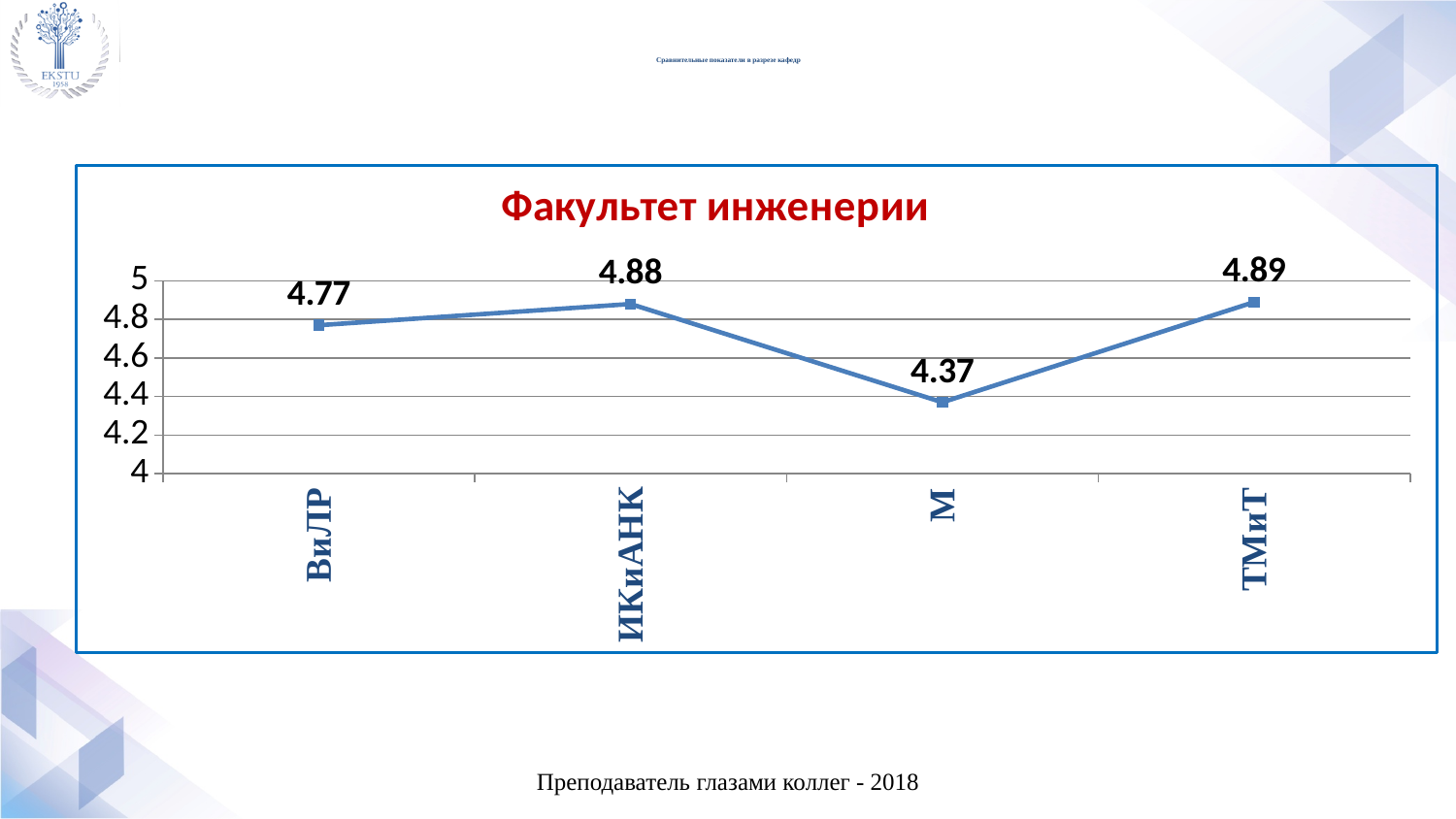
Which category has the lowest value? М What is the difference between the values for ТМиТ and ВиЛР? 0.12 What is the value for ВиЛР? 4.77 What is the value for ТМиТ? 4.89 What is the difference between the values for ИКиАНК and М? 0.51 What is the value for М? 4.37 What is the value for ИКиАНК? 4.88 Which is larger, the value for ВиЛР or the value for М? ВиЛР What is the title of the chart? Факультет инженерии What kind of chart is shown on the slide? line chart How many categories are plotted on the chart? 4 Is the value for М greater or less than 4.6? less